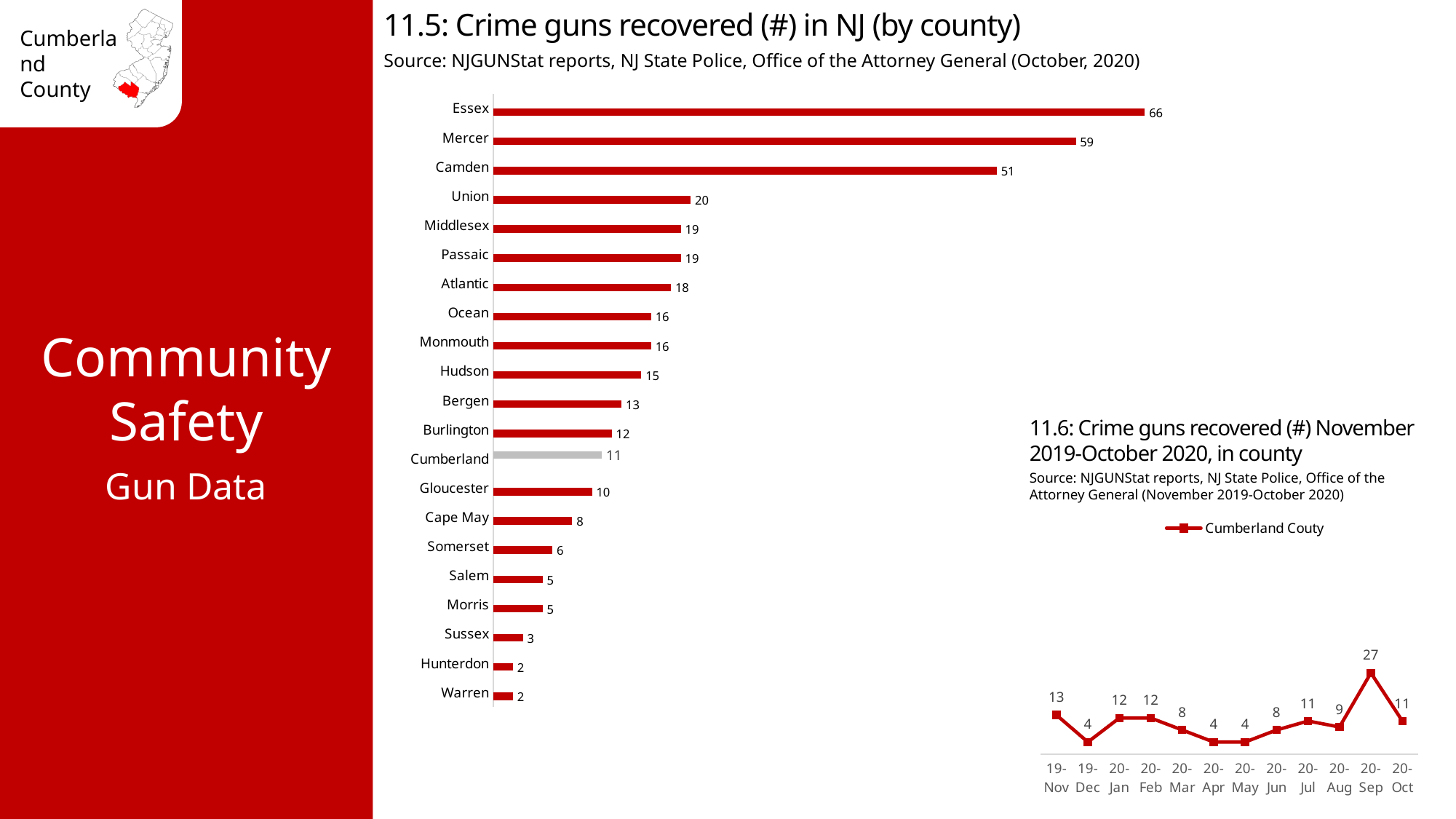
What kind of chart is '11.5: Crime guns recovered (#) in NJ (by county)'? Bar chart In the chart '11.5: Crime guns recovered (#) in NJ (by county)', what is the difference between Essex and Mercer? 7 In the chart '11.6: Crime guns recovered (#) November 2019-October 2020, in county', which month has the lowest value? 19-Dec, 20-Apr and 20-May (all 4) In the chart '11.5: Crime guns recovered (#) in NJ (by county)', which county has the highest value? Essex In the chart '11.5: Crime guns recovered (#) in NJ (by county)', which bar is coloured grey instead of red? Cumberland In the chart '11.5: Crime guns recovered (#) in NJ (by county)', which is larger, Union or Gloucester? Union In the chart '11.5: Crime guns recovered (#) in NJ (by county)', how many counties are shown? 21 In the chart '11.5: Crime guns recovered (#) in NJ (by county)', what is the value for Cumberland? 11 In the chart '11.6: Crime guns recovered (#) November 2019-October 2020, in county', what is the value for 20-Sep? 27 What kind of chart is '11.6: Crime guns recovered (#) November 2019-October 2020, in county'? Line chart In the chart '11.5: Crime guns recovered (#) in NJ (by county)', what is the value for Camden? 51 In the chart '11.6: Crime guns recovered (#) November 2019-October 2020, in county', what is the difference between 20-Sep and 20-Oct? 16